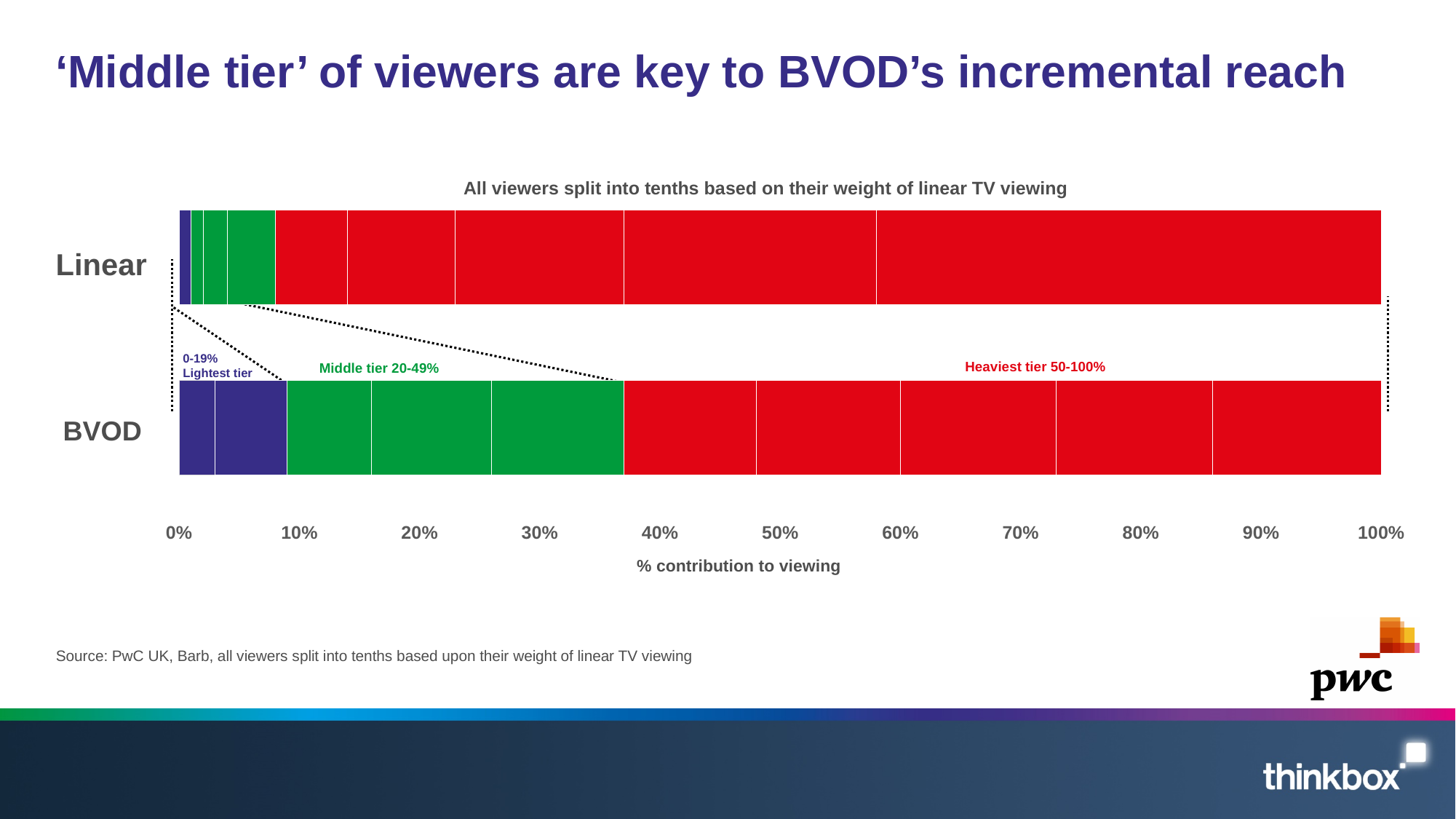
Is the combined contribution of the lightest and middle tiers in the BVOD bar greater or less than 40%? less What kind of chart is shown on the slide? Stacked bar chart Is the contribution of the heaviest tier (50-100%) in the Linear bar greater or less than 90%? greater How many bars (categories) does the chart show? 2 What is the title of the chart? All viewers split into tenths based on their weight of linear TV viewing Is the contribution of the heaviest tier (50-100%) in the BVOD bar greater or less than 70%? less What is the label of the horizontal axis? % contribution to viewing Which bar has the larger contribution to viewing from the middle tier (20-49%), Linear or BVOD? BVOD What are the two categories plotted on the chart? Linear and BVOD Which bar has the larger contribution to viewing from the heaviest tier (50-100%), Linear or BVOD? Linear